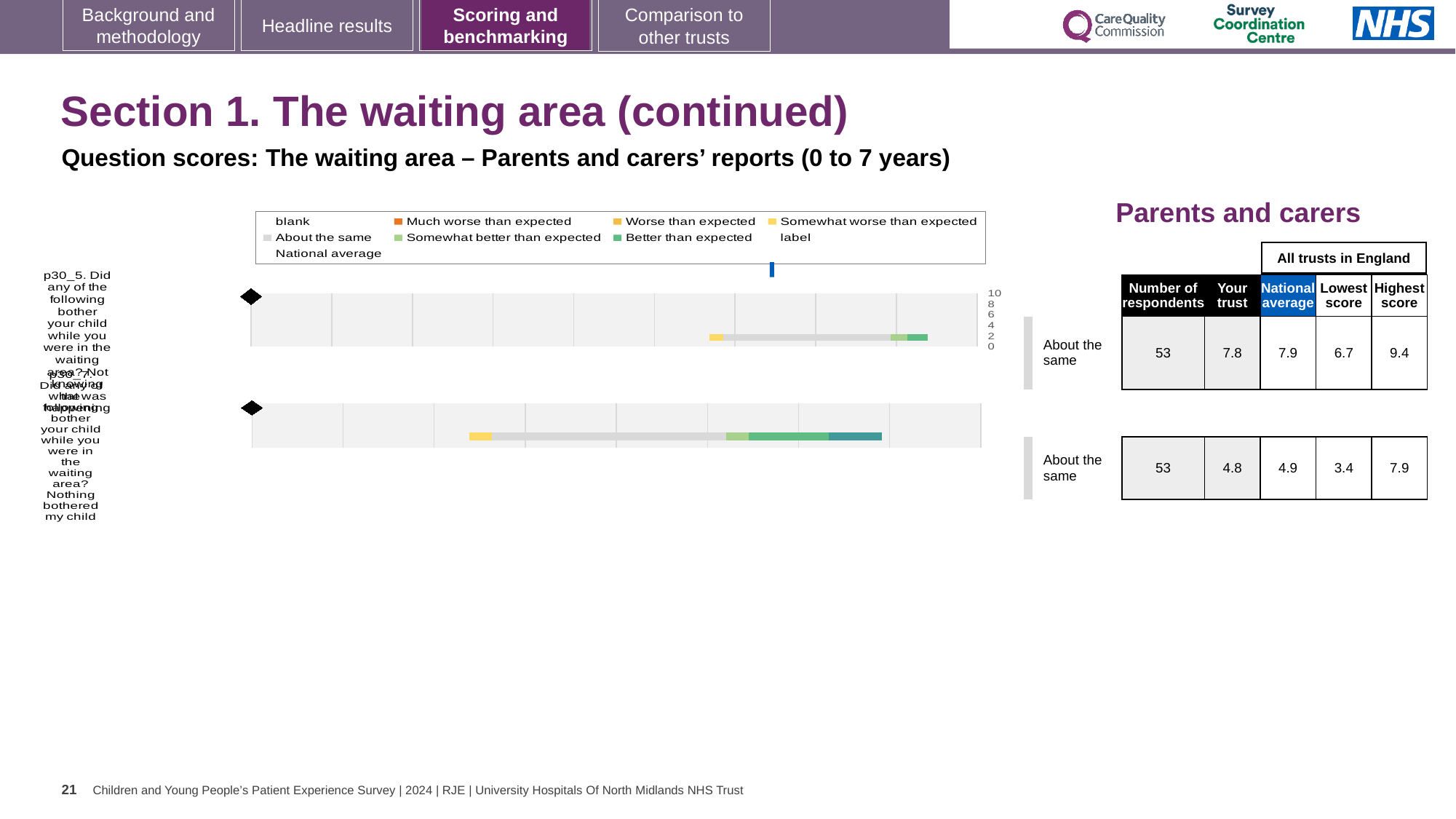
How many questions (bars) are plotted on the slide? 2 How many respondents answered question p30_7? 53 What kind of chart is used to show the question scores on this slide? bar chart What is the national average score for question p30_5? 7.9 What is the 'Your trust' score for question p30_5 (Not knowing what was happening)? 7.8 What benchmark category is shown for the trust on question p30_5? About the same Which question has the higher 'Your trust' score, p30_5 or p30_7? p30_5 What is the highest score among all trusts in England for question p30_5? 9.4 What is the lowest score among all trusts in England for question p30_7? 3.4 What is the difference between the highest and lowest scores for question p30_5? 2.7 What is the 'Your trust' score for question p30_7 (Nothing bothered my child)? 4.8 How many entries does the chart legend list? 9